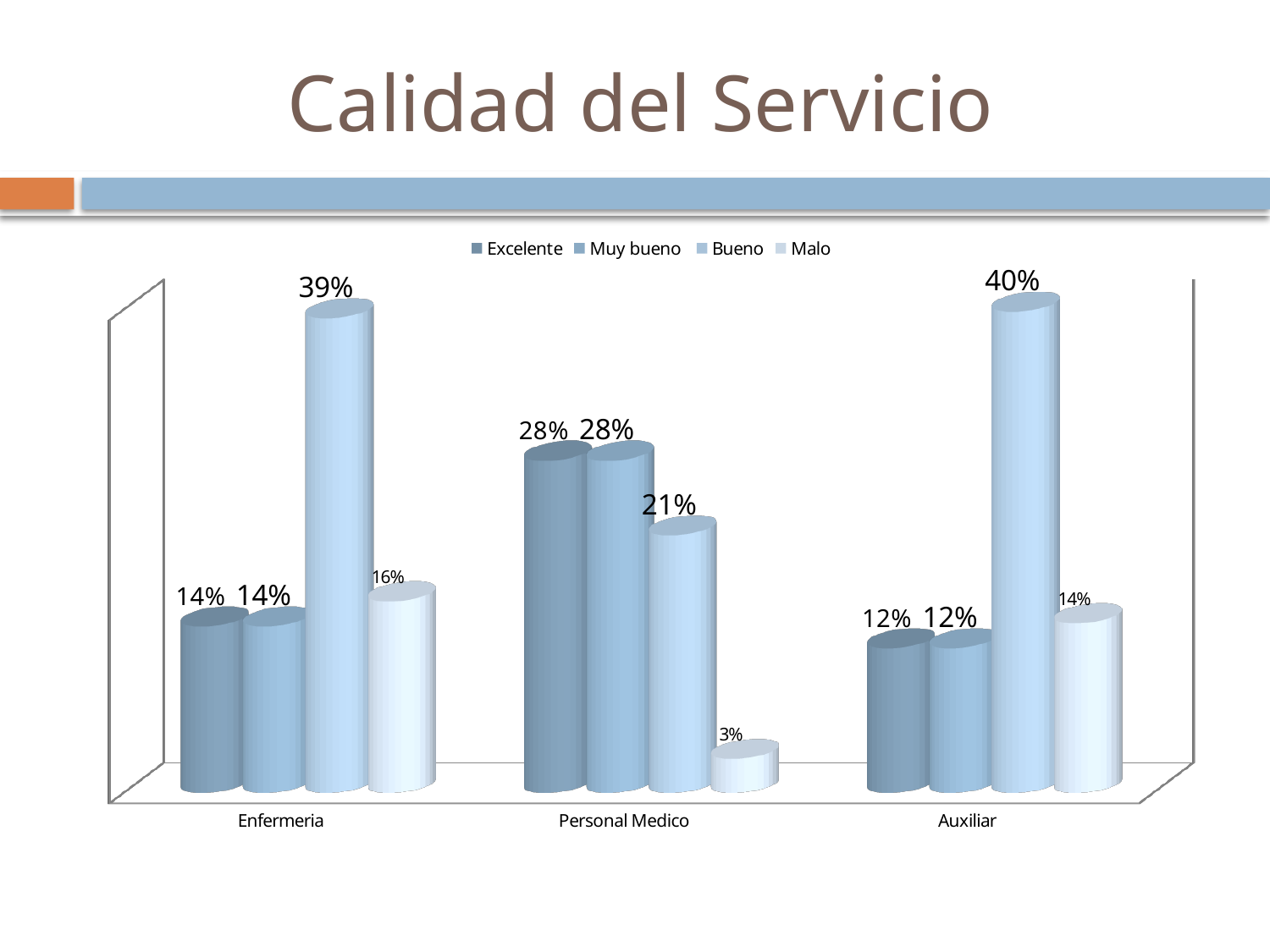
What is the difference between the Excelente value for Personal Medico and the Excelente value for Enfermeria? 14% Which is larger: the Bueno value for Personal Medico or the Malo value for Enfermeria? Bueno value for Personal Medico What is the value for Excelente in the Auxiliar category? 12% Which category has the highest value for Bueno? Auxiliar What is the value for Bueno in the Enfermeria category? 39% What is the value for Malo in the Personal Medico category? 3% How many categories are shown on the x axis? 3 What kind of chart is shown on the slide? Bar chart Which category has the lowest value for Malo? Personal Medico What is the difference between the Bueno value for Auxiliar and the Bueno value for Enfermeria? 1% What is the value for Malo in the Auxiliar category? 14% How many series does the legend list? 4